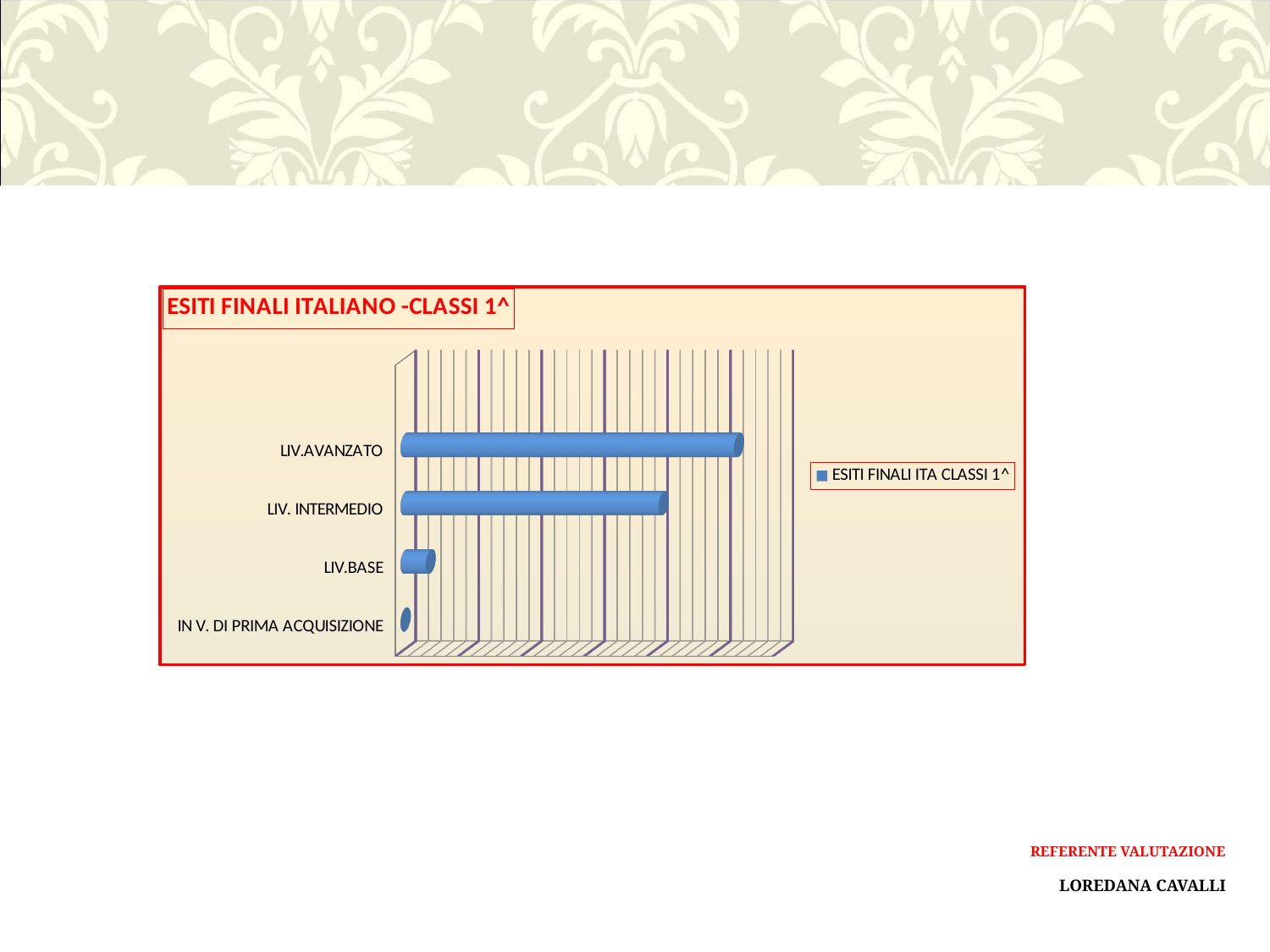
What series name appears in the legend? ESITI FINALI ITA CLASSI 1^ How many categories are shown on the chart? 4 Do the bars get longer or shorter going down the chart from LIV.AVANZATO to IN V. DI PRIMA ACQUISIZIONE? shorter Which category has the shortest bar? IN V. DI PRIMA ACQUISIZIONE What kind of chart is shown on the slide? bar chart What is the title of the chart? ESITI FINALI ITALIANO -CLASSI 1^ Which is larger, the value for LIV.BASE or the value for IN V. DI PRIMA ACQUISIZIONE? LIV.BASE Which category has the longest bar? LIV.AVANZATO Which is larger, the value for LIV. INTERMEDIO or the value for LIV.BASE? LIV. INTERMEDIO Which is larger, the value for LIV.AVANZATO or the value for LIV. INTERMEDIO? LIV.AVANZATO How many series does the legend list? 1